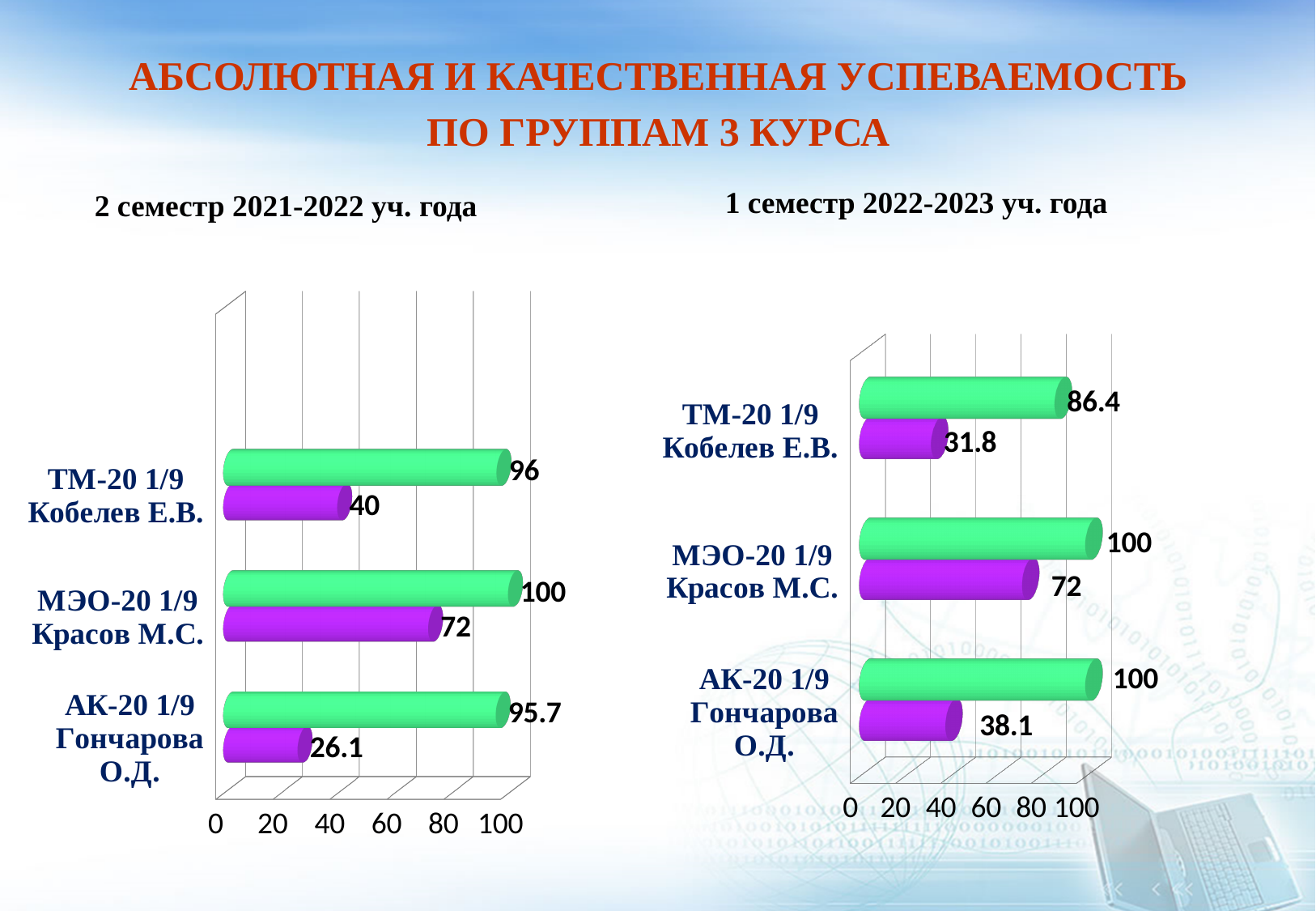
What is the title of the slide containing the two charts? АБСОЛЮТНАЯ И КАЧЕСТВЕННАЯ УСПЕВАЕМОСТЬ ПО ГРУППАМ 3 КУРСА In the chart for 1 семестр 2022-2023 уч. года, what is the value of the purple bar for ТМ-20 1/9 Кобелев Е.В.? 31.8 In the chart for 2 семестр 2021-2022 уч. года, what is the difference between the green and purple bar values for МЭО-20 1/9 Красов М.С.? 28 In the chart for 1 семестр 2022-2023 уч. года, which group has the lowest green bar value? ТМ-20 1/9 Кобелев Е.В. In the chart for 2 семестр 2021-2022 уч. года, what is the value of the green bar for ТМ-20 1/9 Кобелев Е.В.? 96 In the chart for 2 семестр 2021-2022 уч. года, which group has the highest purple bar value? МЭО-20 1/9 Красов М.С. In the chart for 2 семестр 2021-2022 уч. года, which is larger: the purple bar for ТМ-20 1/9 Кобелев Е.В. or the purple bar for АК-20 1/9 Гончарова О.Д.? ТМ-20 1/9 Кобелев Е.В. In the chart for 1 семестр 2022-2023 уч. года, what is the value of the green bar for ТМ-20 1/9 Кобелев Е.В.? 86.4 What type of chart is used for 2 семестр 2021-2022 уч. года? Bar chart In the chart for 2 семестр 2021-2022 уч. года, what is the value of the purple bar for АК-20 1/9 Гончарова О.Д.? 26.1 How many groups are shown in the chart for 1 семестр 2022-2023 уч. года? 3 In the chart for 1 семестр 2022-2023 уч. года, what is the difference between the purple bar values for АК-20 1/9 Гончарова О.Д. and ТМ-20 1/9 Кобелев Е.В.? 6.3